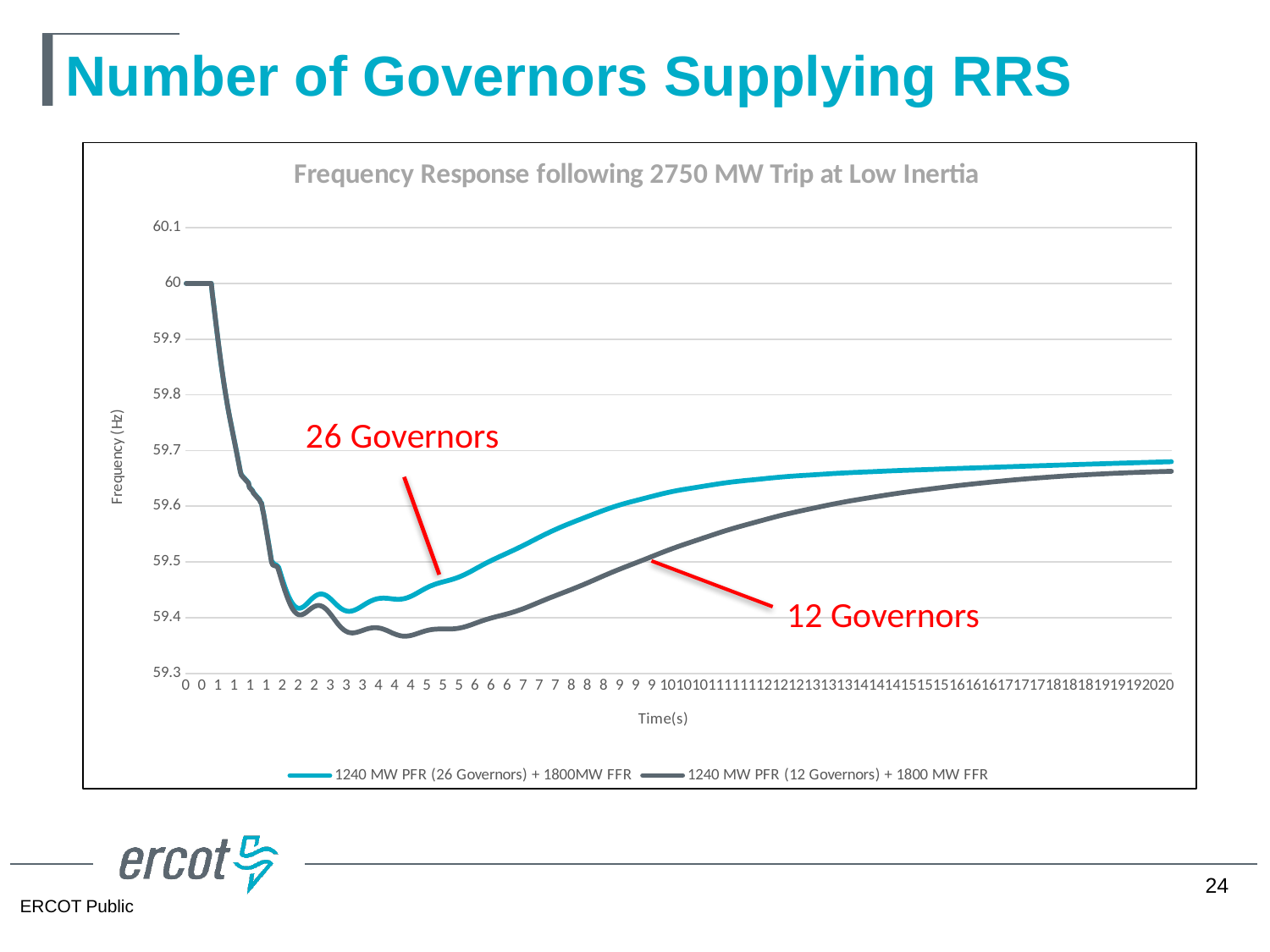
What is the label of the vertical axis? Frequency (Hz) Is the minimum frequency of the 12 Governors series greater or less than 59.4? less How many series does the chart legend list? 2 Is the frequency of the 12 Governors series at 20 seconds greater or less than 59.7? less Which series reaches the lower minimum frequency, the 26 Governors series or the 12 Governors series? 12 Governors Is the frequency of the 26 Governors series at 10 seconds greater or less than 59.5? greater What kind of chart is shown on the slide? Line chart What is the title of the chart? Frequency Response following 2750 MW Trip at Low Inertia What frequency value do both series start at before the trip? 60 After reaching their minimum, do the frequency values of both series rise or fall as time increases? rise Which series recovers to a higher frequency at 10 seconds, the 26 Governors series or the 12 Governors series? 26 Governors